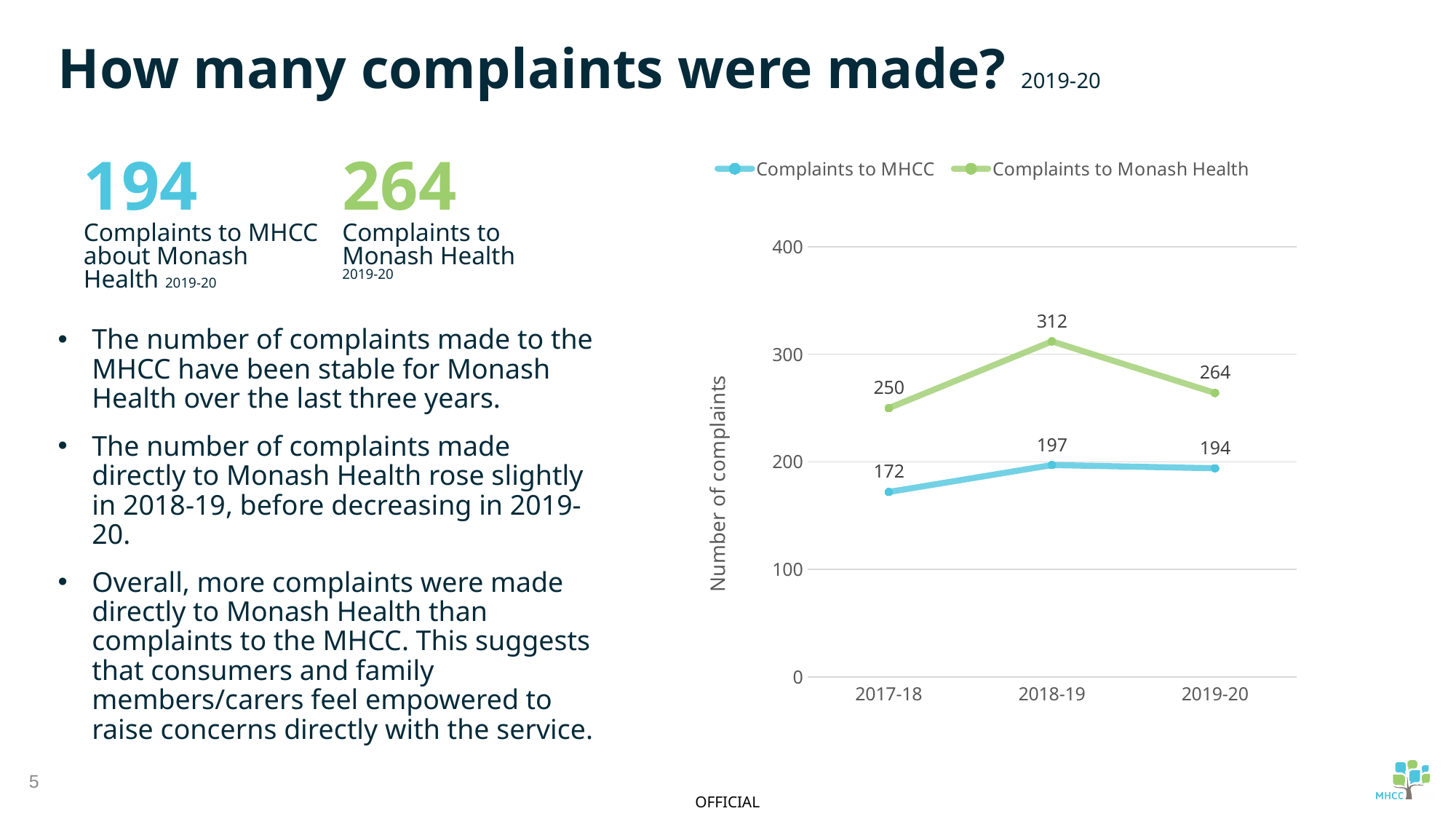
What is the value for Complaints to Monash Health in 2019-20? 264 How many series does the chart legend list? 2 Which series has the larger value in 2017-18, Complaints to MHCC or Complaints to Monash Health? Complaints to Monash Health How many years are plotted along the x axis of the chart? 3 What is the label on the y axis of the chart? Number of complaints What is the value for Complaints to Monash Health in 2018-19? 312 In which year were Complaints to MHCC lowest? 2017-18 What is the value for Complaints to MHCC in 2017-18? 172 In which year were Complaints to Monash Health highest? 2018-19 What kind of chart is shown on the slide? line chart Is the value for Complaints to Monash Health in 2018-19 greater or less than 300? greater What is the difference between Complaints to Monash Health and Complaints to MHCC in 2019-20? 70